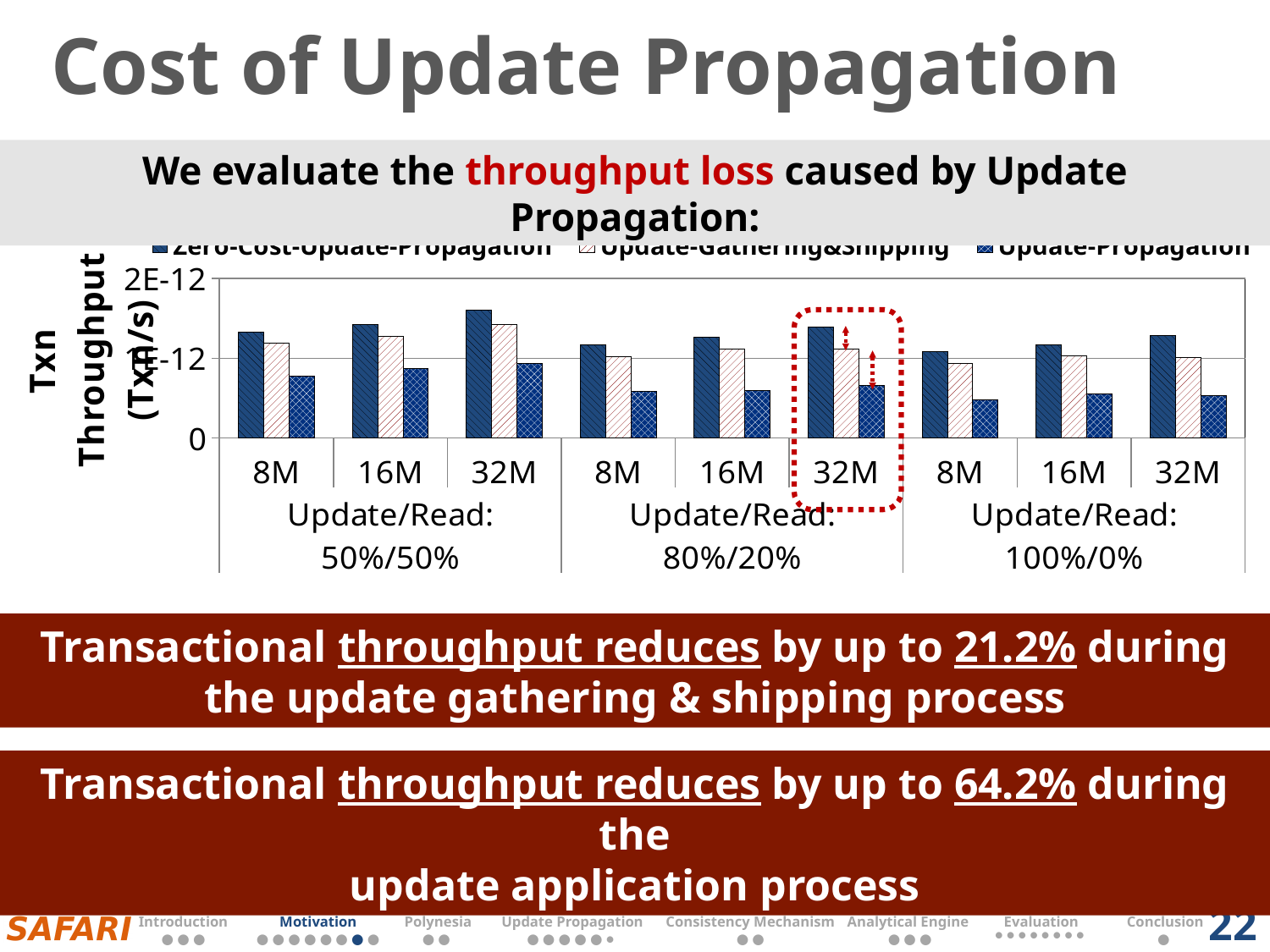
How many bar groups (x-axis categories) are plotted in the chart? 9 Which series has the highest bar overall in the chart? Zero-Cost-Update-Propagation Within the Update/Read 80%/20% group, which series has the lowest bars? Update-Propagation Is the Update-Propagation value for 8M at Update/Read 100%/0% greater or less than 1E-12? less Is the Zero-Cost-Update-Propagation value for 32M at Update/Read 50%/50% greater or less than 1E-12? greater What is the label of the y axis? Txn Throughput (Txn/s) Within the Update/Read 50%/50% group, do the Zero-Cost-Update-Propagation bars rise or fall from 8M to 32M? rise Is the Update-Gathering&Shipping value for 16M at Update/Read 50%/50% greater or less than 1E-12? greater Which three Update/Read ratios are shown along the x axis? 50%/50%, 80%/20%, 100%/0% What kind of chart is shown on the slide? bar chart For 8M at Update/Read 50%/50%, which is larger: Zero-Cost-Update-Propagation or Update-Propagation? Zero-Cost-Update-Propagation How many series does the chart legend list? 3